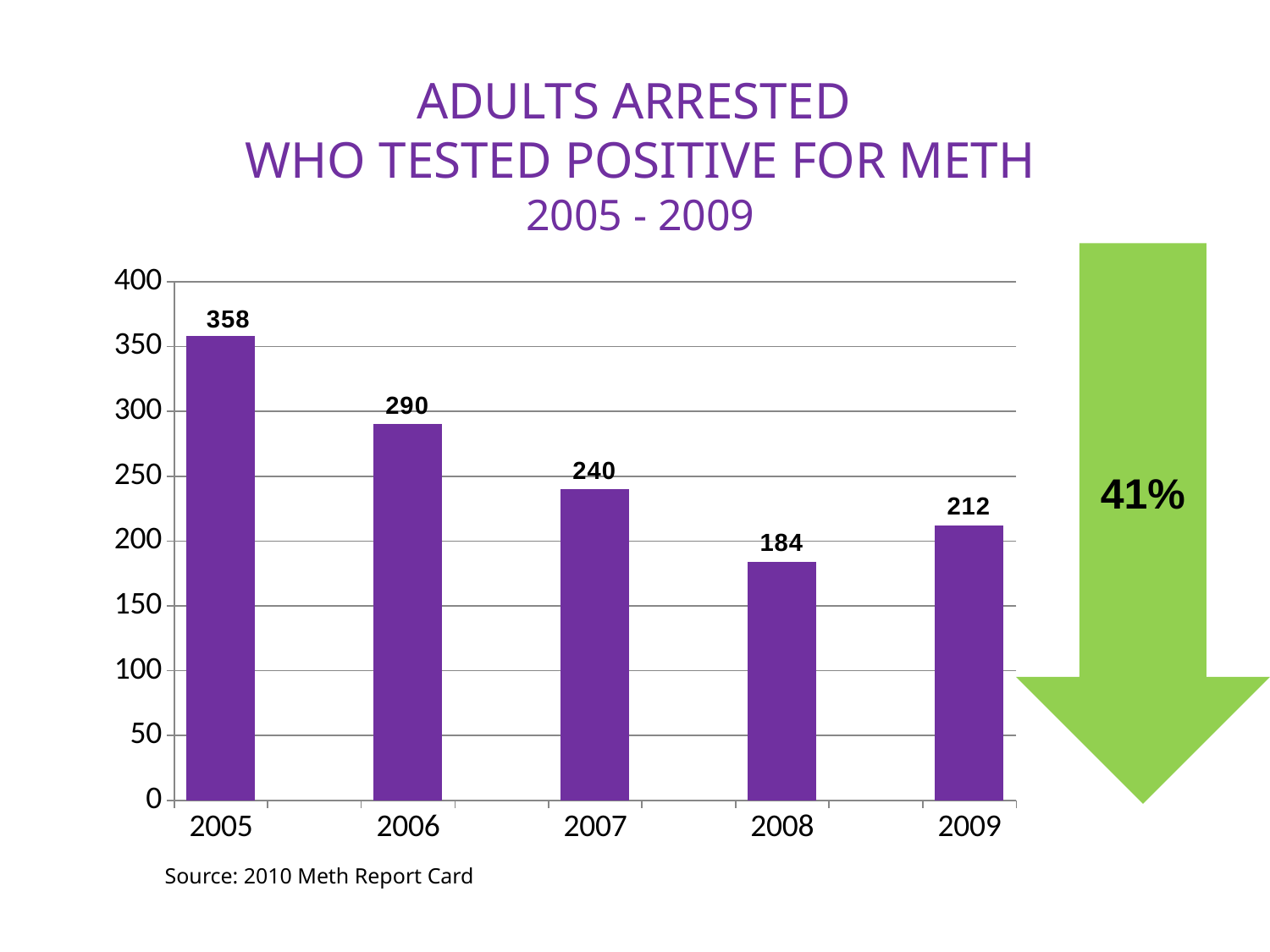
Which year has the highest value? 2005 What kind of chart is shown on the slide? bar chart Which is larger, the value for 2008 or the value for 2009? 2009 What is the value for 2008? 184 How many years are shown on the x axis? 5 What is the difference between the values for 2006 and 2007? 50 Is the value for 2007 greater or less than 250? less What is the difference between the values for 2005 and 2009? 146 What is the value for 2005? 358 What percentage is shown in the green arrow next to the chart? 41% Which year has the lowest value? 2008 What is the value for 2009? 212